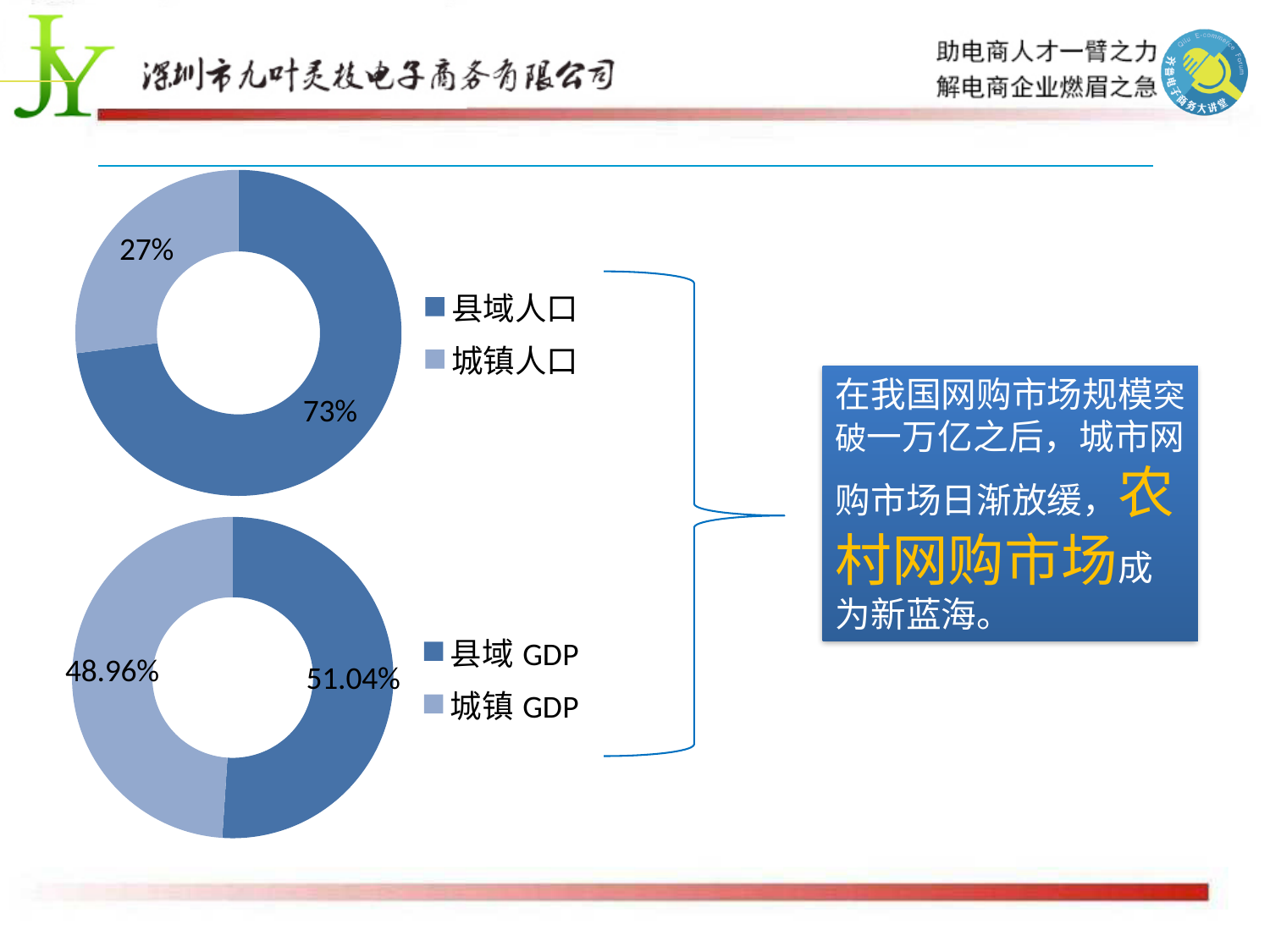
In the bottom chart, which category has the smallest share? 城镇 GDP In the top chart, which is larger, 县域人口 or 城镇人口? 县域人口 In the bottom chart, what is the value for 县域 GDP? 51.04% In the bottom chart, what is the value for 城镇 GDP? 48.96% In the top chart, what is the difference between 县域人口 and 城镇人口? 46% In the top chart, what is the value for 城镇人口? 27% In the top chart, what is the value for 县域人口? 73% What type of chart is the top chart? Doughnut chart In the bottom chart, what is the difference between 县域 GDP and 城镇 GDP? 2.08% In the top chart, which category has the largest share? 县域人口 How many categories does the bottom chart show? 2 How many entries does the legend of the top chart list? 2